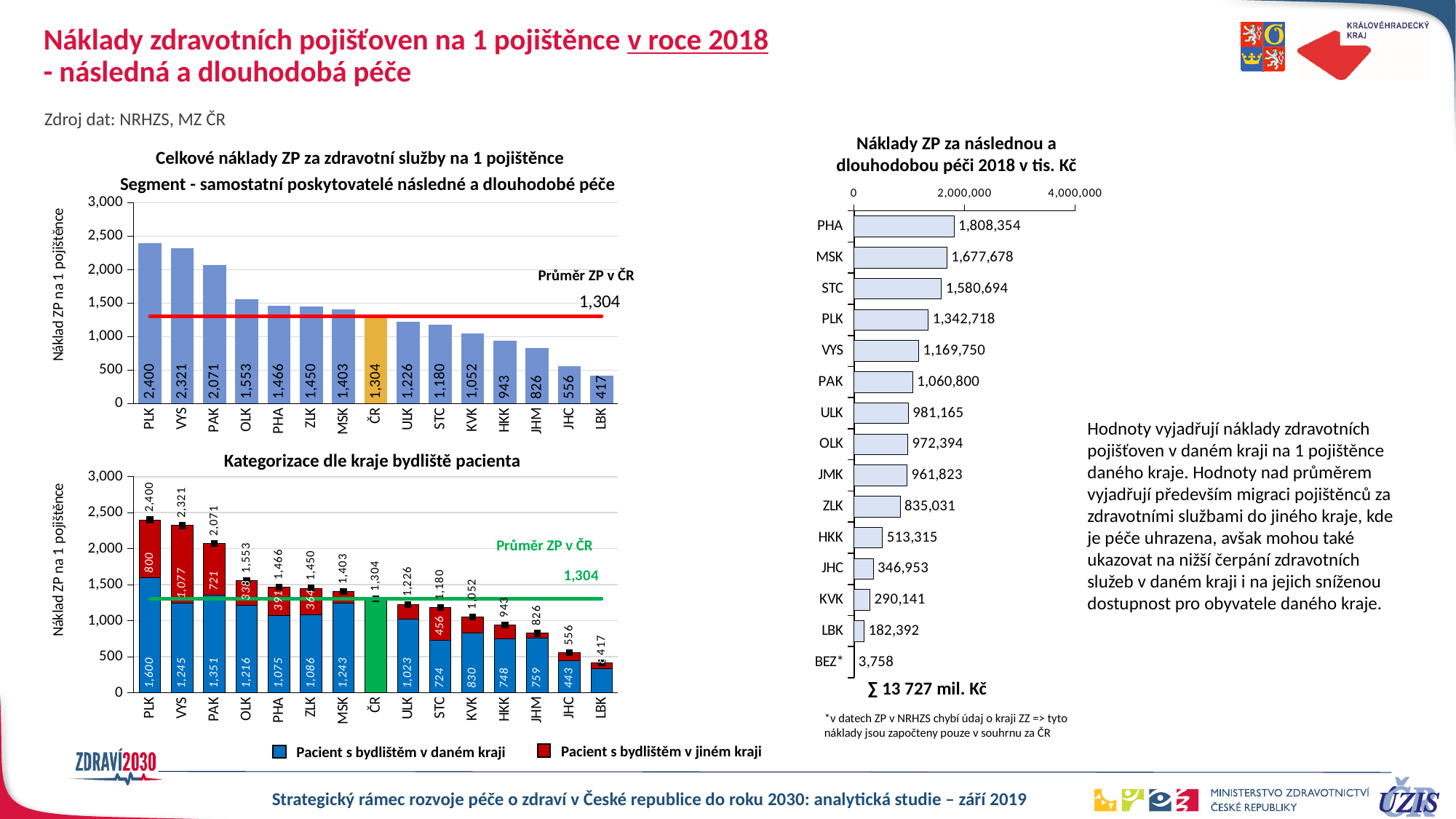
In the right chart 'Náklady ZP za následnou a dlouhodobou péči 2018 v tis. Kč', what is the value for HKK? 513,315 In the top-left chart 'Celkové náklady ZP za zdravotní služby na 1 pojištěnce', what is the value for PLK? 2,400 In the top-left chart 'Celkové náklady ZP za zdravotní služby na 1 pojištěnce', what is the value of the ČR average (Průměr ZP v ČR)? 1,304 In the bottom-left chart 'Kategorizace dle kraje bydliště pacienta', what is the value of 'Pacient s bydlištěm v daném kraji' for PLK? 1,600 In the top-left chart 'Celkové náklady ZP za zdravotní služby na 1 pojištěnce', how many bars are plotted? 15 In the bottom-left chart 'Kategorizace dle kraje bydliště pacienta', what colour represents 'Pacient s bydlištěm v jiném kraji'? Red In the bottom-left chart 'Kategorizace dle kraje bydliště pacienta', what is the value of 'Pacient s bydlištěm v jiném kraji' for STC? 456 In the bottom-left chart 'Kategorizace dle kraje bydliště pacienta', how many series does the legend list? 2 In the right chart 'Náklady ZP za následnou a dlouhodobou péči 2018 v tis. Kč', which region has the highest value? PHA In the top-left chart 'Celkové náklady ZP za zdravotní služby na 1 pojištěnce', what is the difference between the values for PLK and VYS? 79 In the right chart 'Náklady ZP za následnou a dlouhodobou péči 2018 v tis. Kč', which is larger, the value for STC or the value for PLK? STC In the top-left chart 'Celkové náklady ZP za zdravotní služby na 1 pojištěnce', which region has the lowest value? LBK